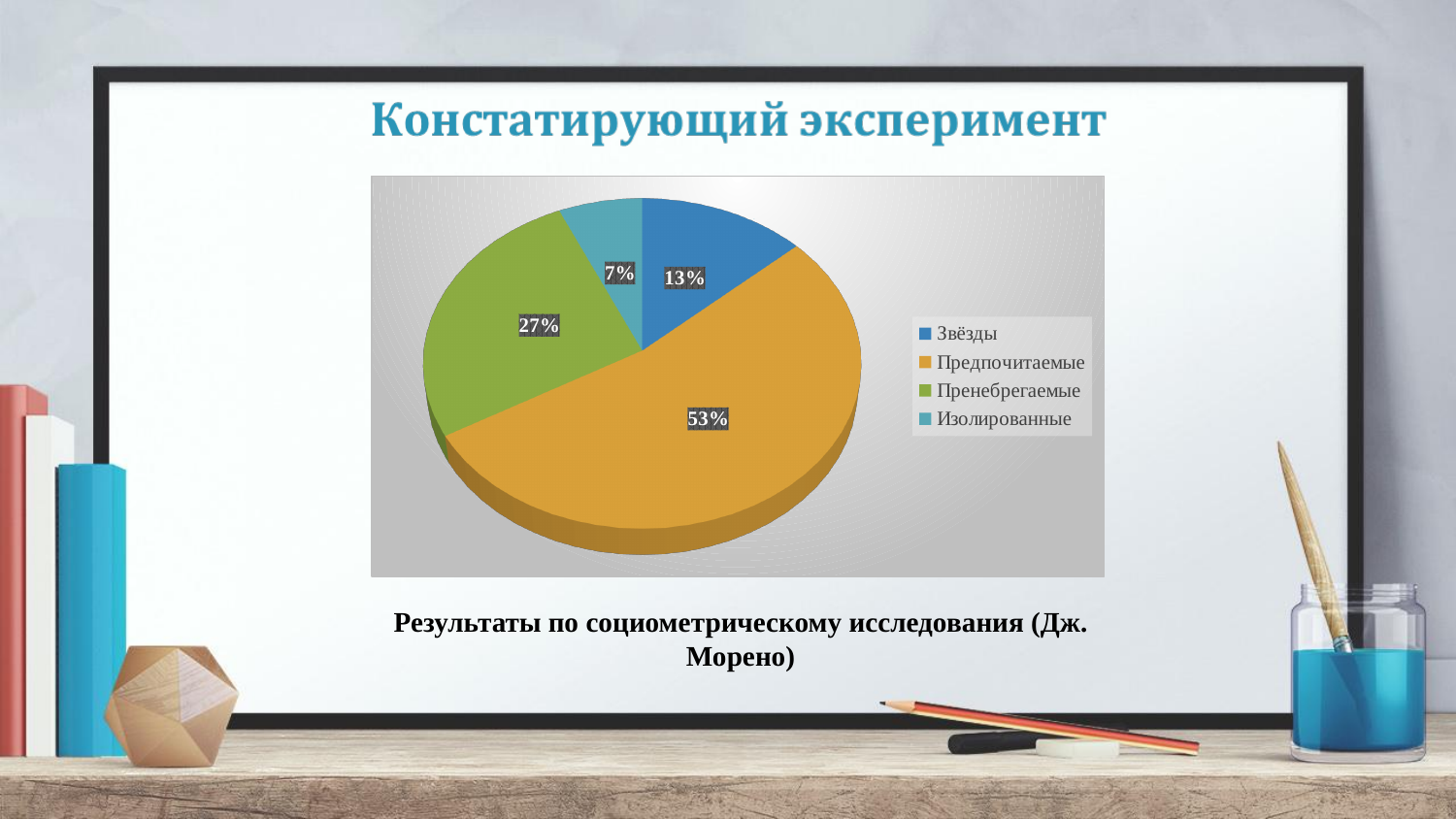
Which is larger, the value for Звёзды or the value for Пренебрегаемые? Пренебрегаемые What is the value for Изолированные? 7% What share of the pie does Предпочитаемые have? 53% What colour is the slice for Звёзды? blue What is the difference between the values for Предпочитаемые and Пренебрегаемые? 26% Which category has the largest slice? Предпочитаемые Which category has the smallest slice? Изолированные How many categories does the pie chart have? 4 What is the value for Звёзды? 13% What kind of chart is shown on the slide? pie chart What is the value for Пренебрегаемые? 27% How many entries does the legend list? 4